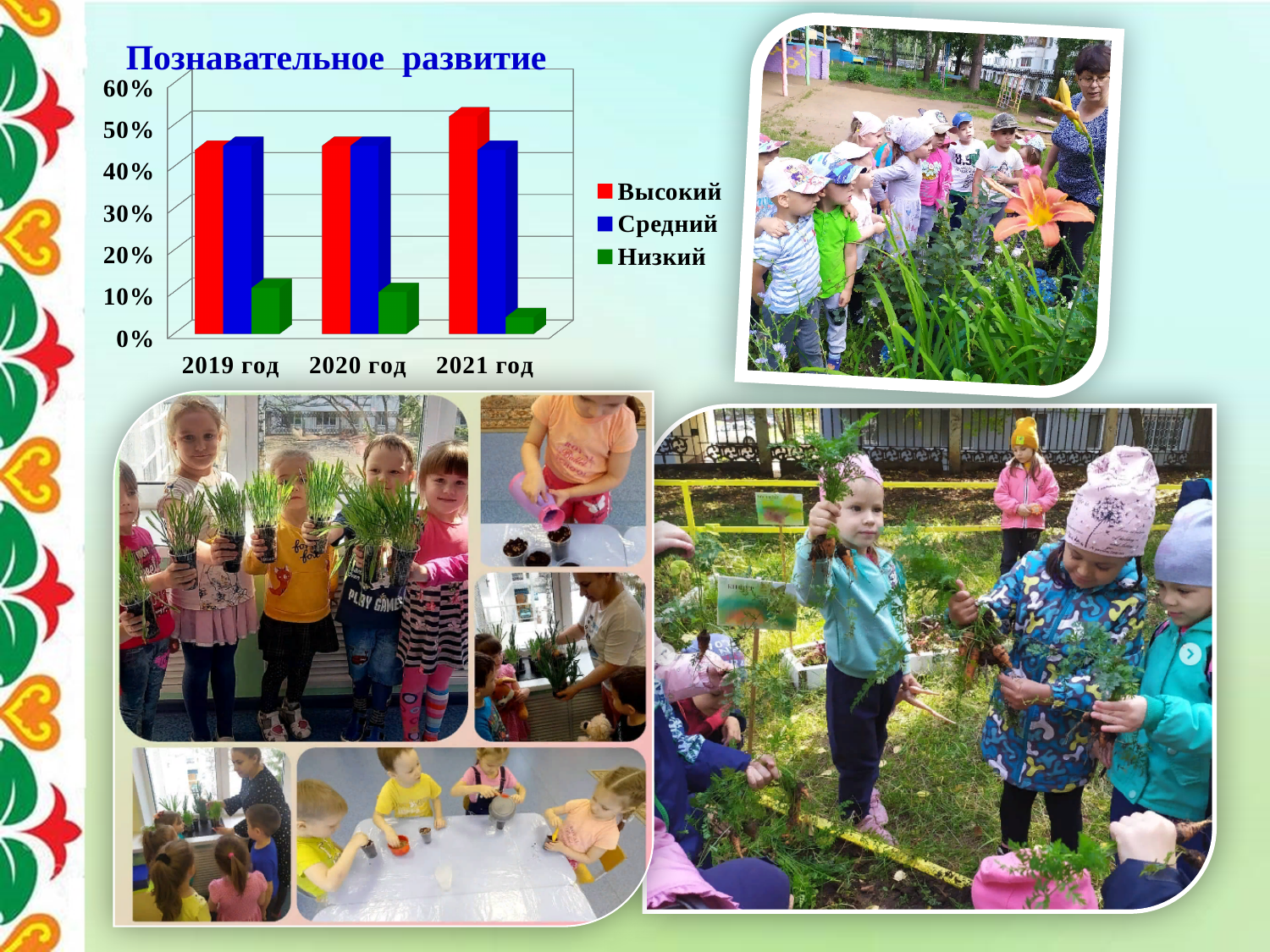
Which is larger: the value for Низкий in 2019 год or in 2021 год? 2019 год Which series has the lowest value in 2021 год? Низкий Which colour represents the series Низкий in the chart? green Is the value for Низкий in 2021 год greater or less than 10%? less Is the value for Высокий in 2021 год greater or less than 50%? greater How many years (categories) are shown on the x axis of the chart? 3 How many series does the chart's legend list? 3 What is the title of the chart? Познавательное развитие Which is larger: the value for Высокий in 2019 год or in 2021 год? 2021 год Is the value for Низкий in 2019 год greater or less than 20%? less What kind of chart is shown on the slide? bar chart Which series has the highest value in 2021 год? Высокий